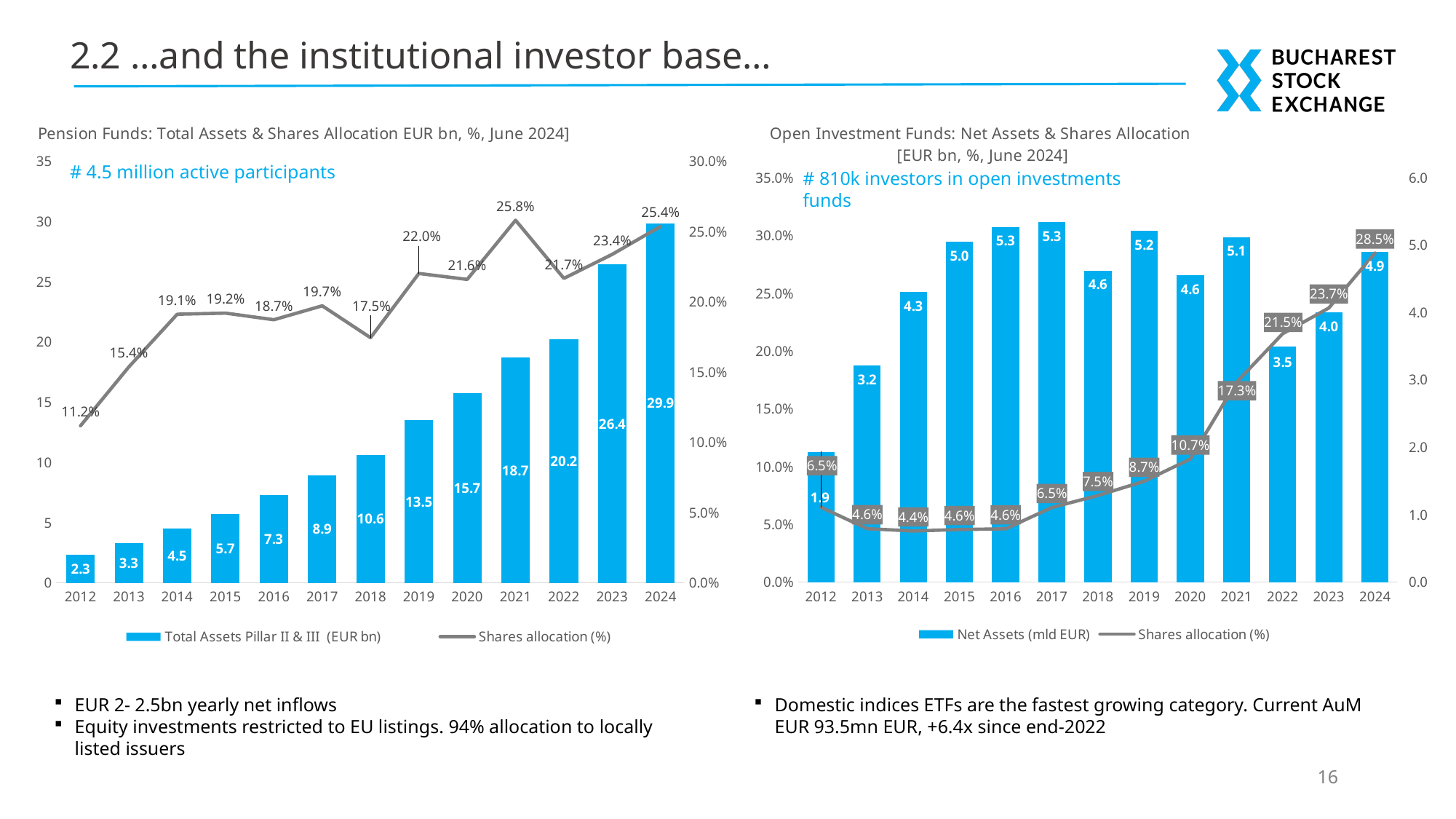
In the Open Investment Funds chart, what is the shares allocation for 2024? 28.5% In the Open Investment Funds chart, what is the Net Assets value for 2016? 5.3 In the Pension Funds chart, what is the difference in Total Assets Pillar II & III between 2024 and 2023? 3.5 In the Pension Funds chart, do the Total Assets Pillar II & III values rise or fall from 2012 to 2024? rise In the Pension Funds chart, what is the shares allocation for 2021? 25.8% In the Pension Funds chart, how many series does the legend list? 2 In the Open Investment Funds chart, how many years are shown on the x axis? 13 In the Open Investment Funds chart, which is larger, the Net Assets value for 2021 or for 2022? 2021 What type of chart is the Open Investment Funds chart? Combined bar and line chart In the Pension Funds chart, which year has the lowest Total Assets Pillar II & III? 2012 In the Open Investment Funds chart, which year has the lowest shares allocation? 2014 In the Pension Funds chart, what is the value of Total Assets Pillar II & III for 2024? 29.9